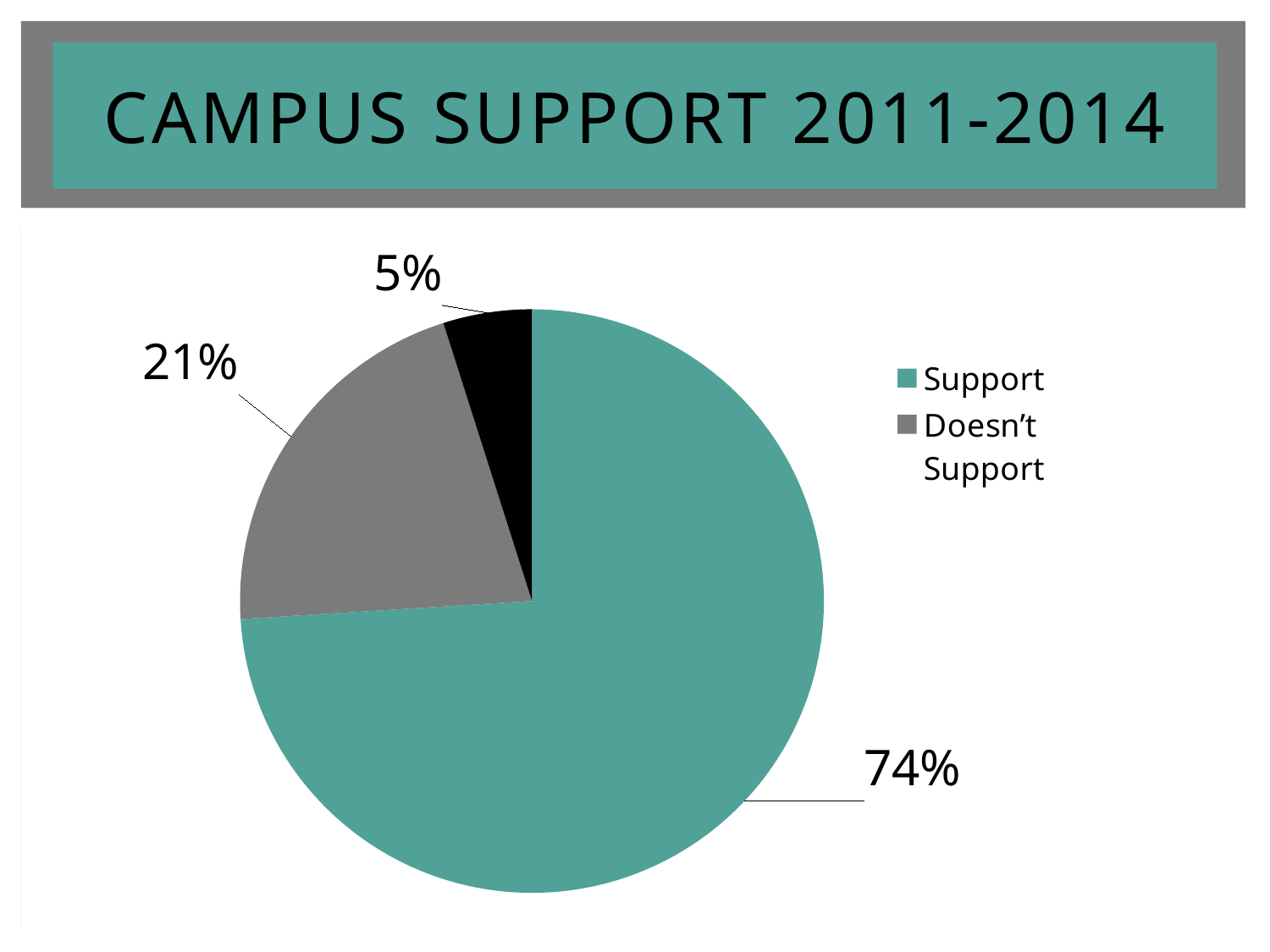
How many slices does the pie chart have? 3 How many entries does the legend list? 2 What percentage of the pie does the Support slice represent? 74% What is the title of the slide? CAMPUS SUPPORT 2011-2014 What kind of chart is shown on the slide? Pie chart What percentage of the pie does the Doesn't Support slice represent? 21% Which is larger, the Support slice or the Doesn't Support slice? Support What colour is the Support slice of the pie? Teal By how many percentage points does the Support slice exceed the Doesn't Support slice? 53 What is the smallest percentage labelled on the pie chart? 5% Which legend category has the largest slice of the pie? Support What share of the pie is taken by the Support slice? 74%